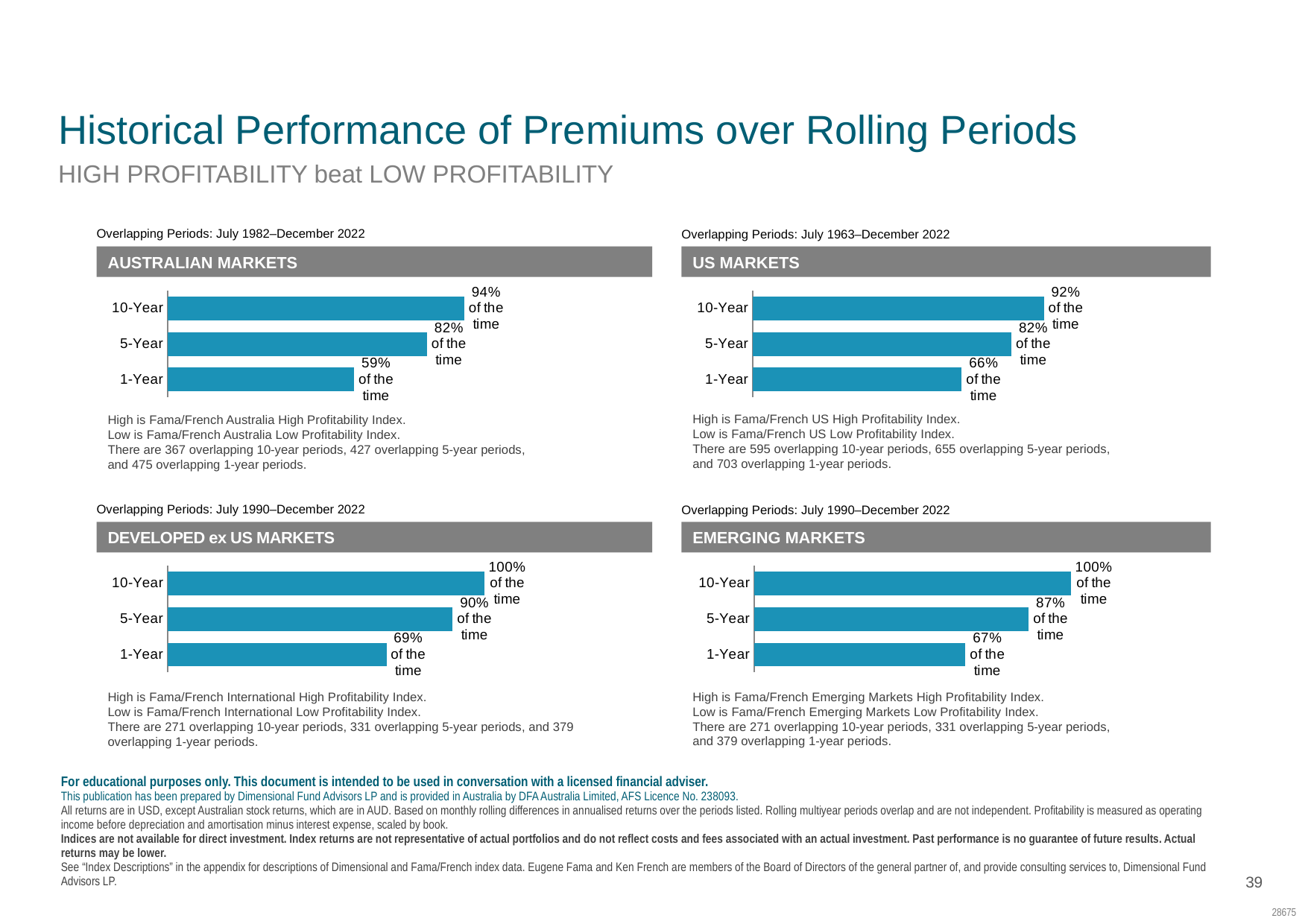
In the US Markets chart, what is the value for 1-Year? 66% In the Australian Markets chart, what is the value for 10-Year? 94% How many periods are shown in the US Markets chart? 3 In the Australian Markets chart, which period has the lowest value? 1-Year In the Developed ex US Markets chart, do the values rise or fall from 1-Year to 10-Year? Rise In the Australian Markets chart, what is the difference between the 10-Year and 1-Year values? 35% In the Developed ex US Markets chart, what is the value for 5-Year? 90% In the Emerging Markets chart, what is the difference between the 5-Year and 1-Year values? 20% In the Developed ex US Markets chart, which is larger, the 1-Year value or the 5-Year value? 5-Year In the US Markets chart, which period has the highest value? 10-Year In the Emerging Markets chart, what is the value for 5-Year? 87% What kind of chart is the Emerging Markets chart? Bar chart